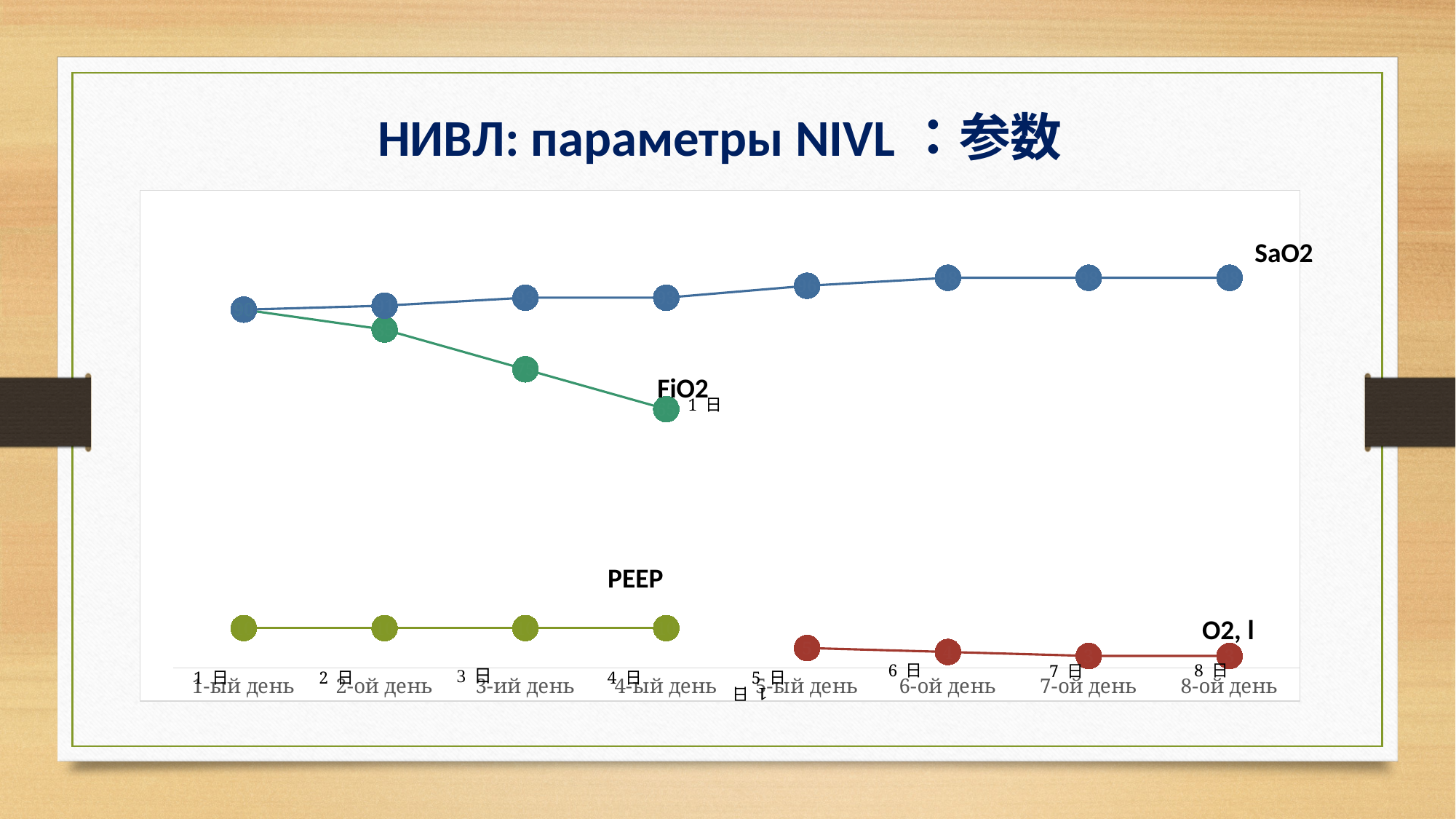
Which series has data points for all 8 days? SaO2 What kind of chart is shown on the slide? Line chart On 4-ый день, which is plotted higher: SaO2 or FiO2? SaO2 Which series are labelled on the chart? SaO2, FiO2, PEEP, O2, l Does the FiO2 series rise or fall from 1-ый день to 4-ый день? Falls Does the SaO2 series rise or fall from 1-ый день to 8-ой день? Rises Does the O2, l series rise or fall from 5-ый день to 8-ой день? Falls On which day does the O2, l series first appear? 5-ый день How many day categories are shown along the x axis? 8 How many data series are labelled on the chart? 4 On 3-ий день, which is plotted higher: FiO2 or PEEP? FiO2